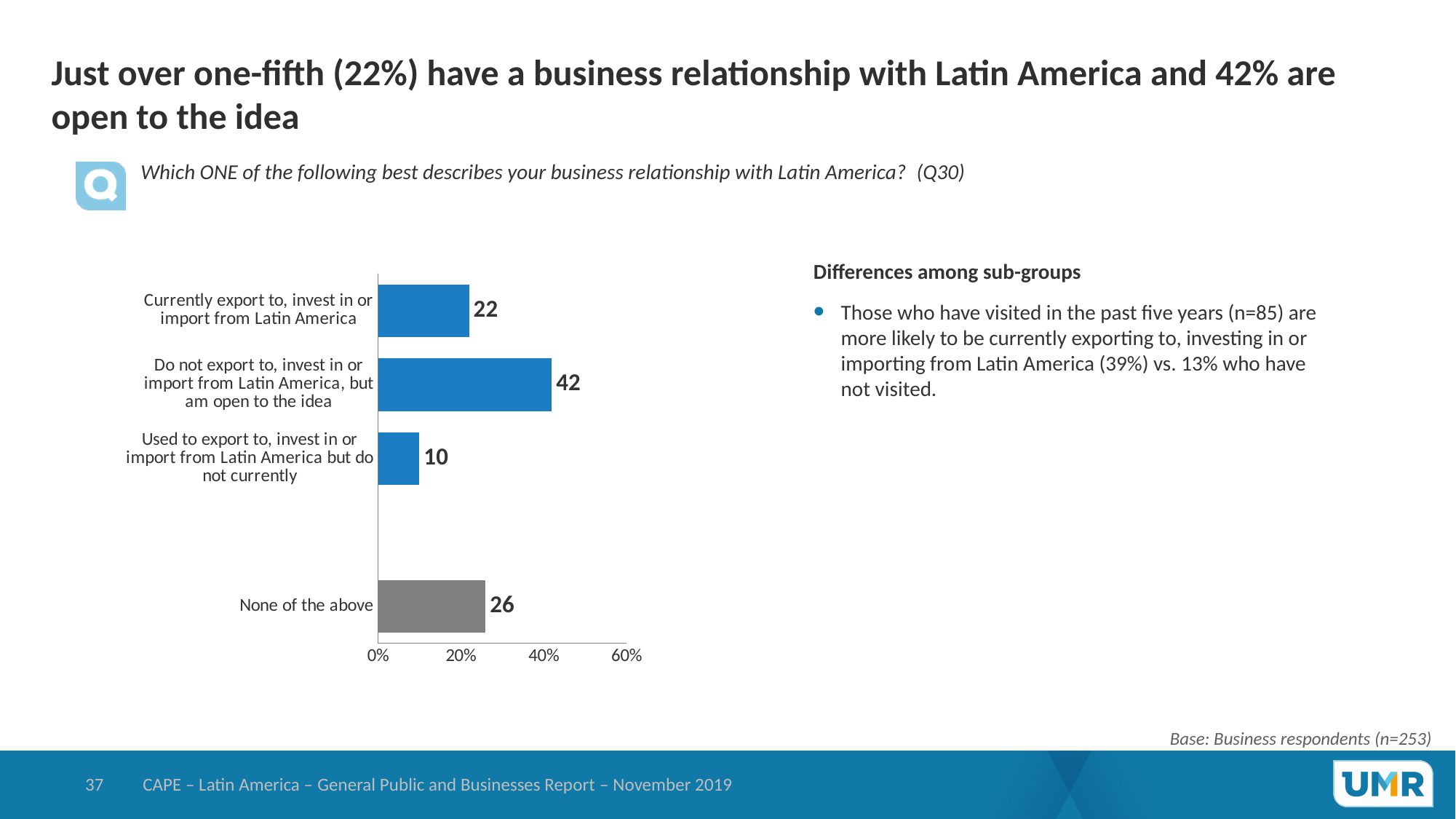
Which category has the highest value? Do not export to, invest in or import from Latin America, but am open to the idea What kind of chart is shown on the slide? bar chart What is the value for 'Currently export to, invest in or import from Latin America'? 22 Which category has the lowest value? Used to export to, invest in or import from Latin America but do not currently What is the value for 'None of the above'? 26 Which bar is coloured grey rather than blue? None of the above Is the value for 'Do not export to, invest in or import from Latin America, but am open to the idea' greater or less than 40%? greater What is the value for 'Do not export to, invest in or import from Latin America, but am open to the idea'? 42 What is the difference between the value for 'Do not export to, invest in or import from Latin America, but am open to the idea' and the value for 'Currently export to, invest in or import from Latin America'? 20 How many categories are shown in the chart? 4 What is the value for 'Used to export to, invest in or import from Latin America but do not currently'? 10 Which is larger: the value for 'None of the above' or the value for 'Currently export to, invest in or import from Latin America'? None of the above